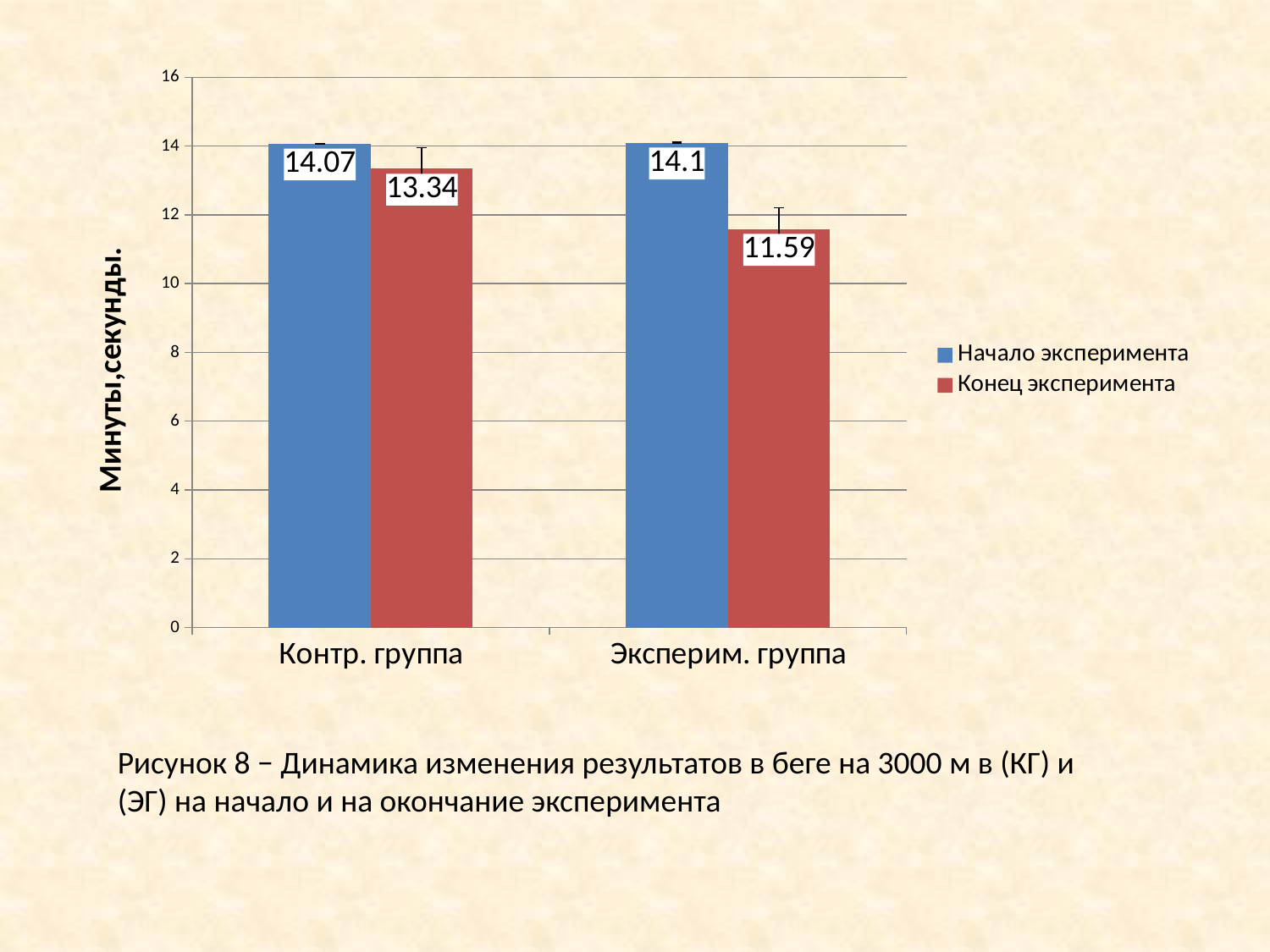
Which category has the lowest value in the Конец эксперимента series? Эксперим. группа Which is larger for Эксперим. группа: the Начало эксперимента value or the Конец эксперимента value? Начало эксперимента How many categories are shown on the x axis? 2 What is the difference between the Начало эксперимента and Конец эксперимента values for Контр. группа? 0.73 What is the value for Эксперим. группа in the Начало эксперимента series? 14.1 What is the value for Эксперим. группа in the Конец эксперимента series? 11.59 What type of chart is shown on the slide? bar chart What is the value for Контр. группа in the Начало эксперимента series? 14.07 Is the Конец эксперимента value for Эксперим. группа greater or less than 12? less What is the value for Контр. группа in the Конец эксперимента series? 13.34 What is the difference between the Начало эксперимента and Конец эксперимента values for Эксперим. группа? 2.51 How many series does the legend list? 2